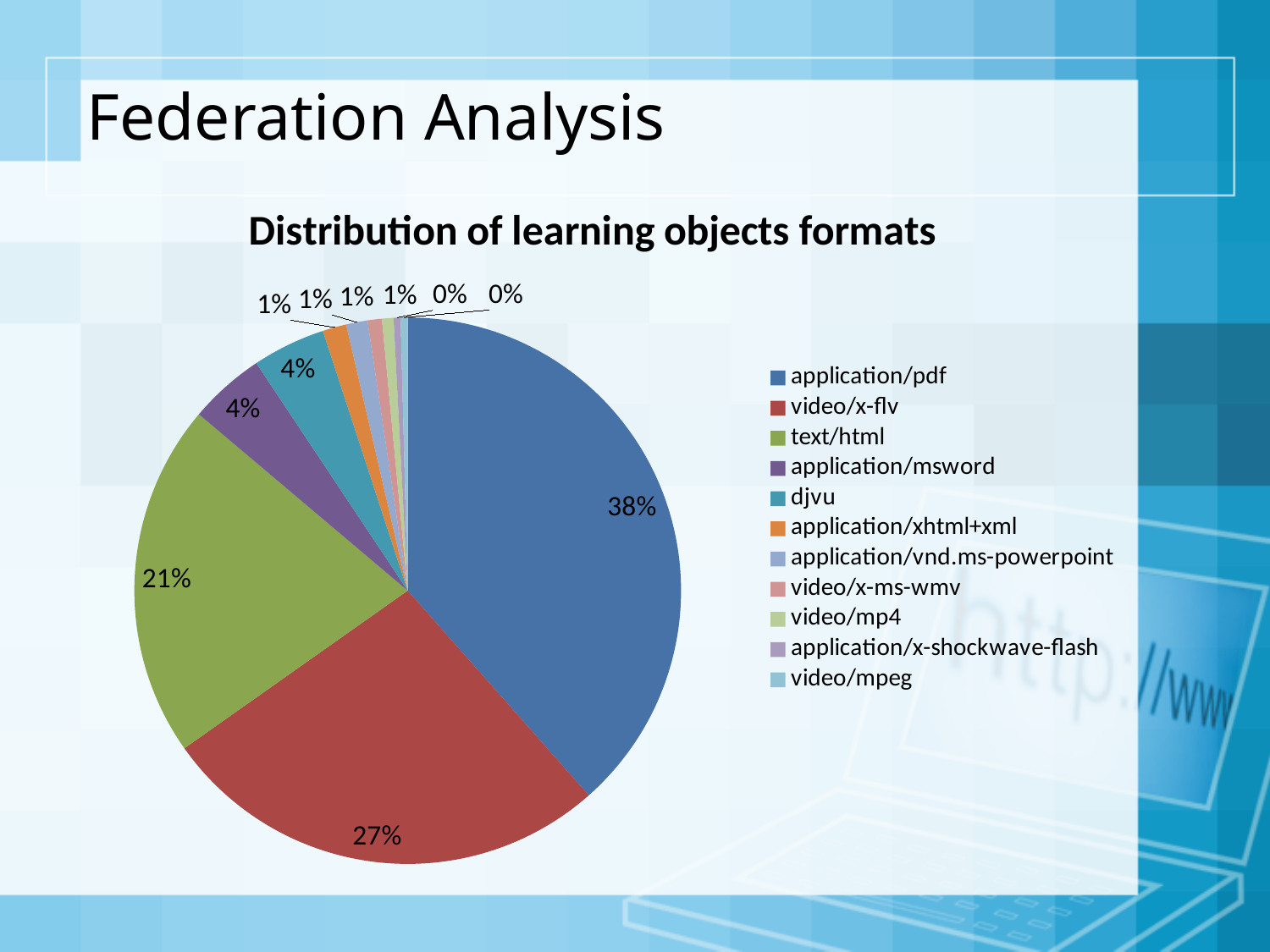
What is the difference between the share for application/pdf and the share for video/x-flv? 11% Which format has the largest share of the pie? application/pdf What kind of chart is shown on the slide? pie chart What is the combined share of application/pdf, video/x-flv and text/html? 86% What share of the pie does text/html take? 21% What share of the pie does video/x-flv take? 27% What is the title of the chart? Distribution of learning objects formats What share of the pie does djvu take? 4% Which is larger, the share for video/x-flv or the share for text/html? video/x-flv How many formats does the legend list? 11